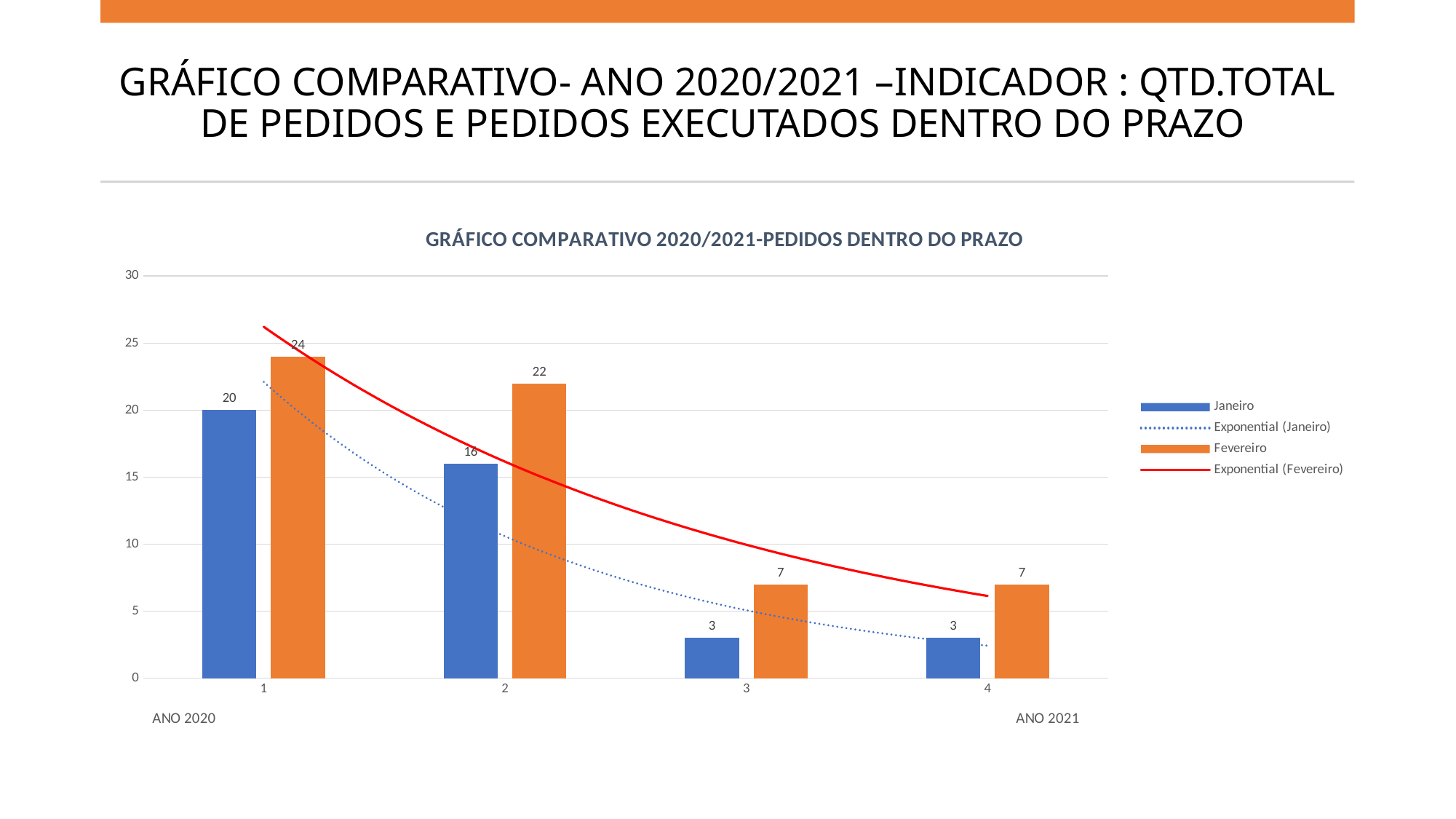
What is the value of Fevereiro for category 4? 7 Do the Janeiro values rise or fall from category 1 to category 4? Fall What kind of chart is shown? Bar chart Which category has the lowest Fevereiro value? 3 and 4 What is the value of Fevereiro for category 2? 22 What is the value of Janeiro for category 1? 20 Which is larger for category 2: Janeiro or Fevereiro? Fevereiro What is the difference between the Fevereiro and Janeiro values for category 1? 4 How many entries does the legend list? 4 What is the difference between the Janeiro values for category 1 and category 2? 4 Which category has the highest Fevereiro value? 1 How many categories are shown on the x axis? 4